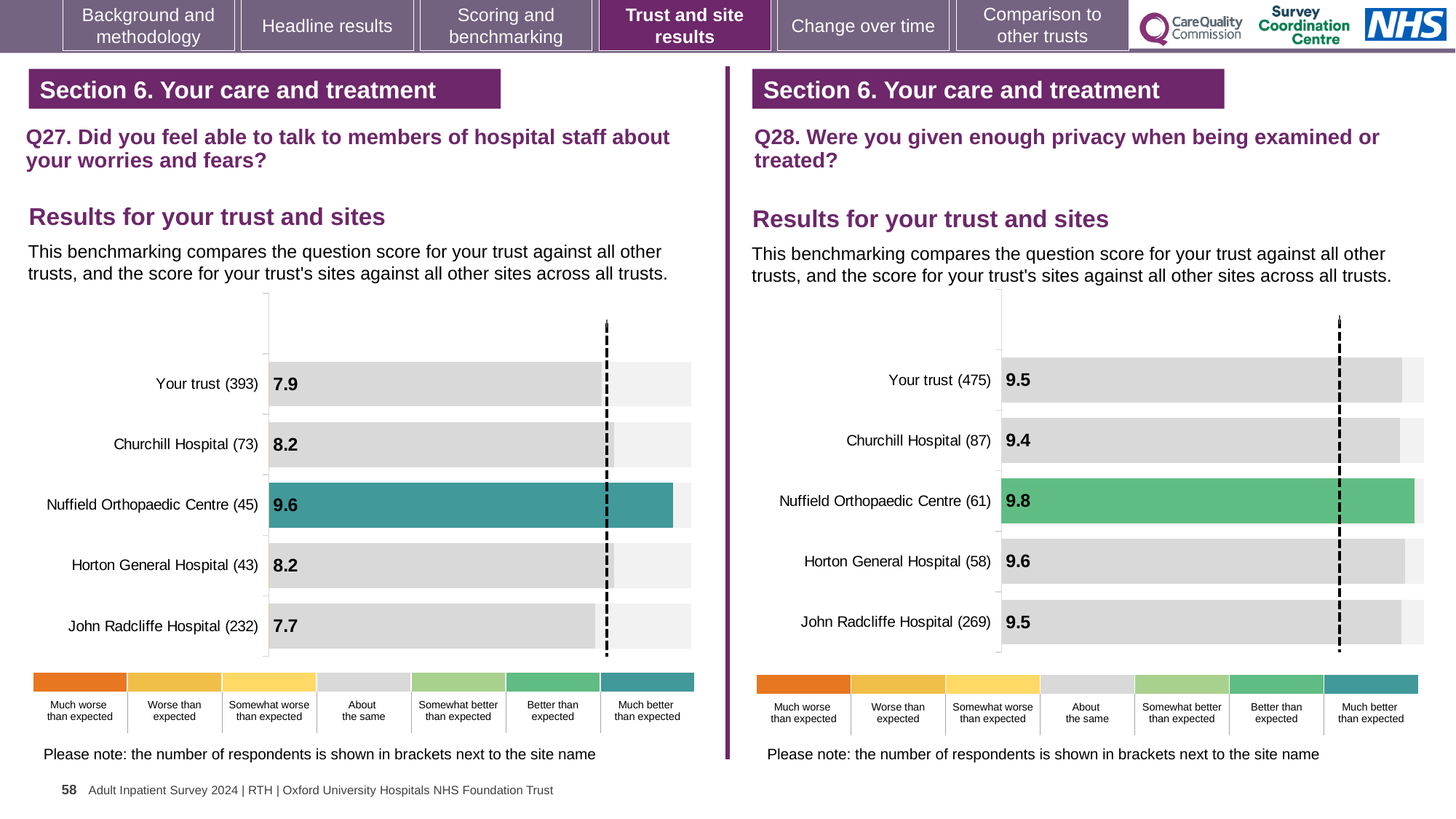
In the Q27 chart on the left, what is the difference between the scores for Nuffield Orthopaedic Centre and Your trust? 1.7 In the Q27 chart on the left, what is the score for Your trust (393)? 7.9 In the Q27 chart on the left, which has the higher score, Churchill Hospital or John Radcliffe Hospital? Churchill Hospital In the Q28 chart on the right, what is the difference between the scores for Nuffield Orthopaedic Centre and Churchill Hospital? 0.4 What type of chart is used for the Q27 results on the left? Bar chart In the Q27 chart on the left, which site has the highest score? Nuffield Orthopaedic Centre (45) In the Q28 chart on the right, which site has the highest score? Nuffield Orthopaedic Centre (61) In the Q27 chart on the left, what is the score for John Radcliffe Hospital (232)? 7.7 How many bars are plotted in the Q28 chart on the right? 5 In the Q28 chart on the right, what is the score for Churchill Hospital (87)? 9.4 In the Q28 chart on the right, what is the score for Horton General Hospital (58)? 9.6 In the Q27 chart on the left, which site has the lowest score? John Radcliffe Hospital (232)